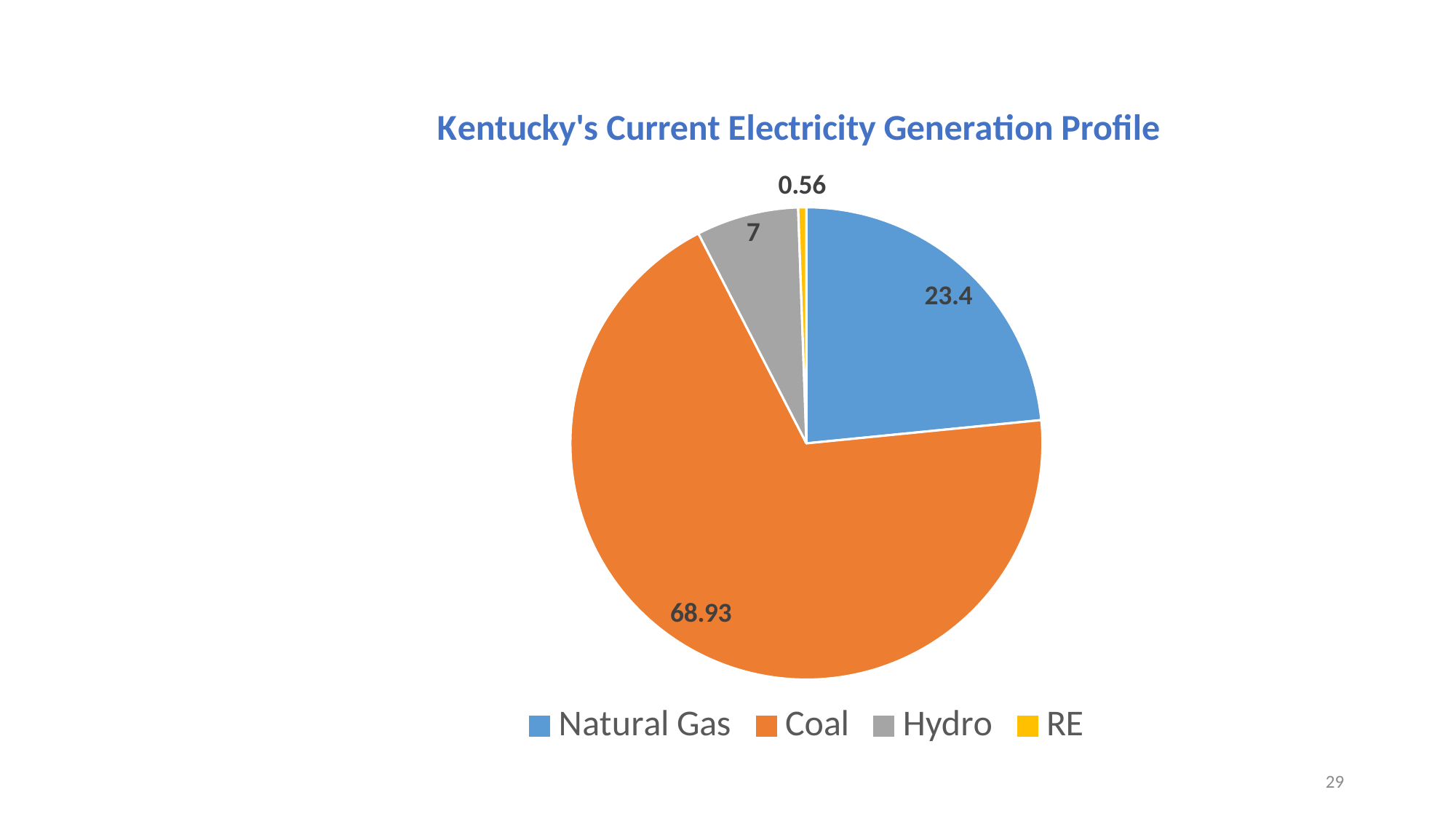
What is the difference between the values for Coal and Natural Gas? 45.53 What is the value for Coal? 68.93 Which is larger, the value for Hydro or the value for Natural Gas? Natural Gas Which category has the smallest slice? RE Which colour represents Hydro in the legend? Grey What is the value for Hydro? 7 What is the title of the chart? Kentucky's Current Electricity Generation Profile Which category has the largest slice? Coal How many categories does the pie chart show? 4 What is the value for Natural Gas? 23.4 What is the value for RE? 0.56 What kind of chart is shown on the slide? Pie chart